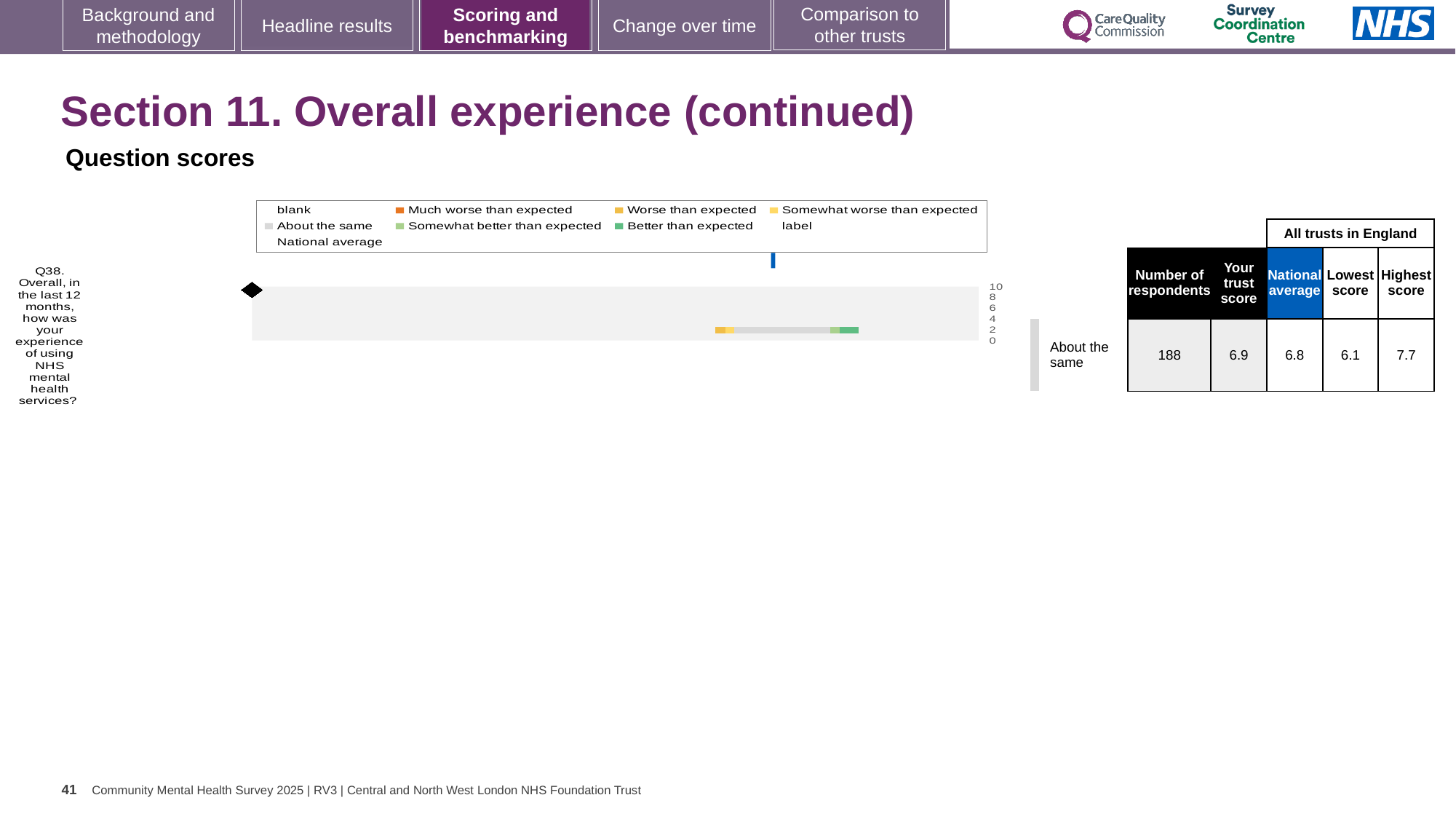
What is the difference between the highest and lowest scores among all trusts in England for Q38? 1.6 In the table beside the chart, what is the national average score for Q38? 6.8 Which question is plotted in the chart? Q38. Overall, in the last 12 months, how was your experience of using NHS mental health services? What is the benchmark category shown for Q38 next to the chart? About the same In the table beside the chart, what is the lowest score among all trusts in England for Q38? 6.1 How many survey questions are plotted in the chart? 1 In the table beside the chart, what is the trust's score for Q38? 6.9 What kind of chart is shown on the slide? bar chart Which is larger for Q38, the trust's score or the national average? the trust's score In the table beside the chart, what is the number of respondents for Q38? 188 In the table beside the chart, what is the highest score among all trusts in England for Q38? 7.7 What is the highest value shown on the chart's axis? 10